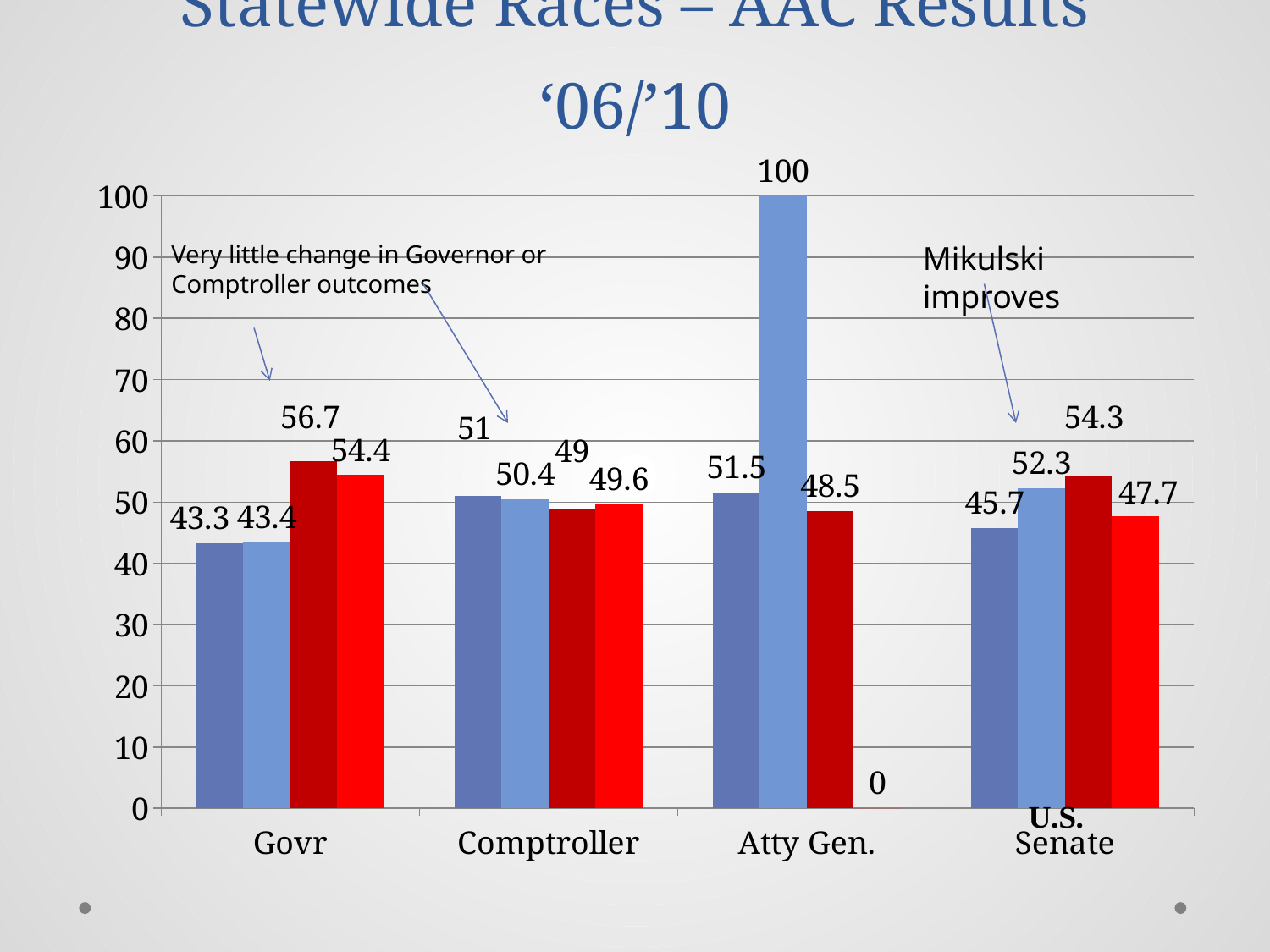
What is the value of the dark red bar for U.S. Senate? 54.3 Which category contains the highest bar in the chart? Atty Gen. Is the value of the dark blue bar for Comptroller greater or less than 40? greater What is the value of the lowest bar in the chart, shown in the Atty Gen. category? 0 What is the difference between the dark red bar (56.7) and the dark blue bar (43.3) for Govr? 13.4 Which is larger for U.S. Senate: the light blue bar or the dark blue bar? the light blue bar What is the value of the bright red (fourth) bar for Comptroller? 49.6 What type of chart is shown on the slide? bar chart What is the value of the first (dark blue) bar for Govr? 43.3 What is the title of the chart on the slide? Statewide Races – AAC Results '06/'10 What is the value of the tallest bar in the Atty Gen. category? 100 How many categories are shown on the x axis of the chart? 4